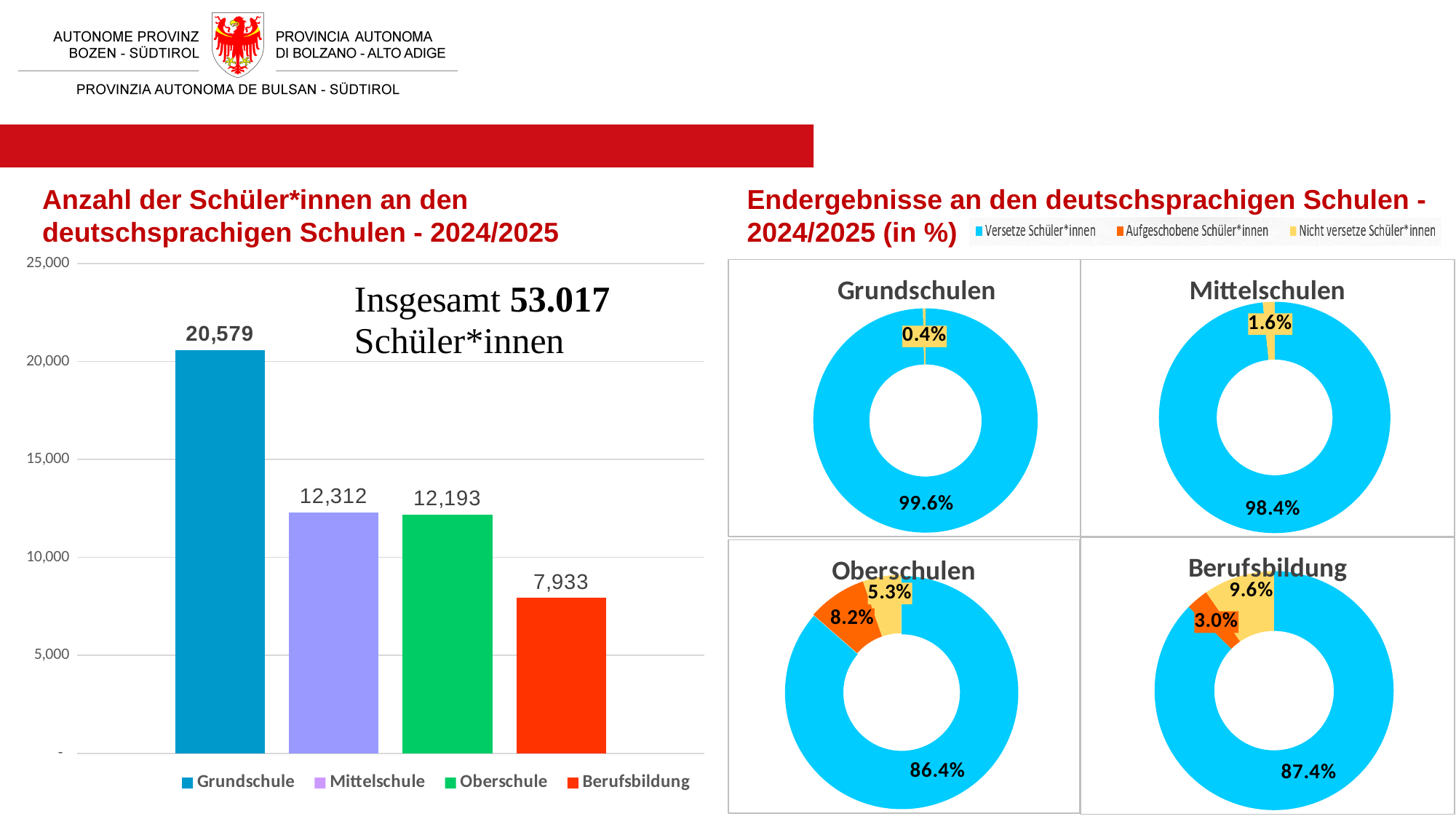
In the bar chart on the left, what is the difference between the values for Grundschule and Berufsbildung? 12,646 In the 'Berufsbildung' donut chart on the right, what share is shown for Nicht versetze Schüler*innen? 9.6% In the bar chart on the left, how many categories are shown? 4 What kind of chart is the chart on the left of the slide? Bar chart How many series does the legend of the donut charts on the right list? 3 In the bar chart on the left, which category has the highest value? Grundschule In the 'Grundschulen' donut chart on the right, what share is shown for Versetze Schüler*innen? 99.6% In the 'Oberschulen' donut chart on the right, what share is shown for Aufgeschobene Schüler*innen? 8.2% In the bar chart on the left, which is larger, the value for Mittelschule or the value for Oberschule? Mittelschule In the bar chart on the left, which category has the lowest value? Berufsbildung In the bar chart on the left, what is the value for Berufsbildung? 7,933 In the bar chart 'Anzahl der Schüler*innen an den deutschsprachigen Schulen - 2024/2025', what is the value for Grundschule? 20,579